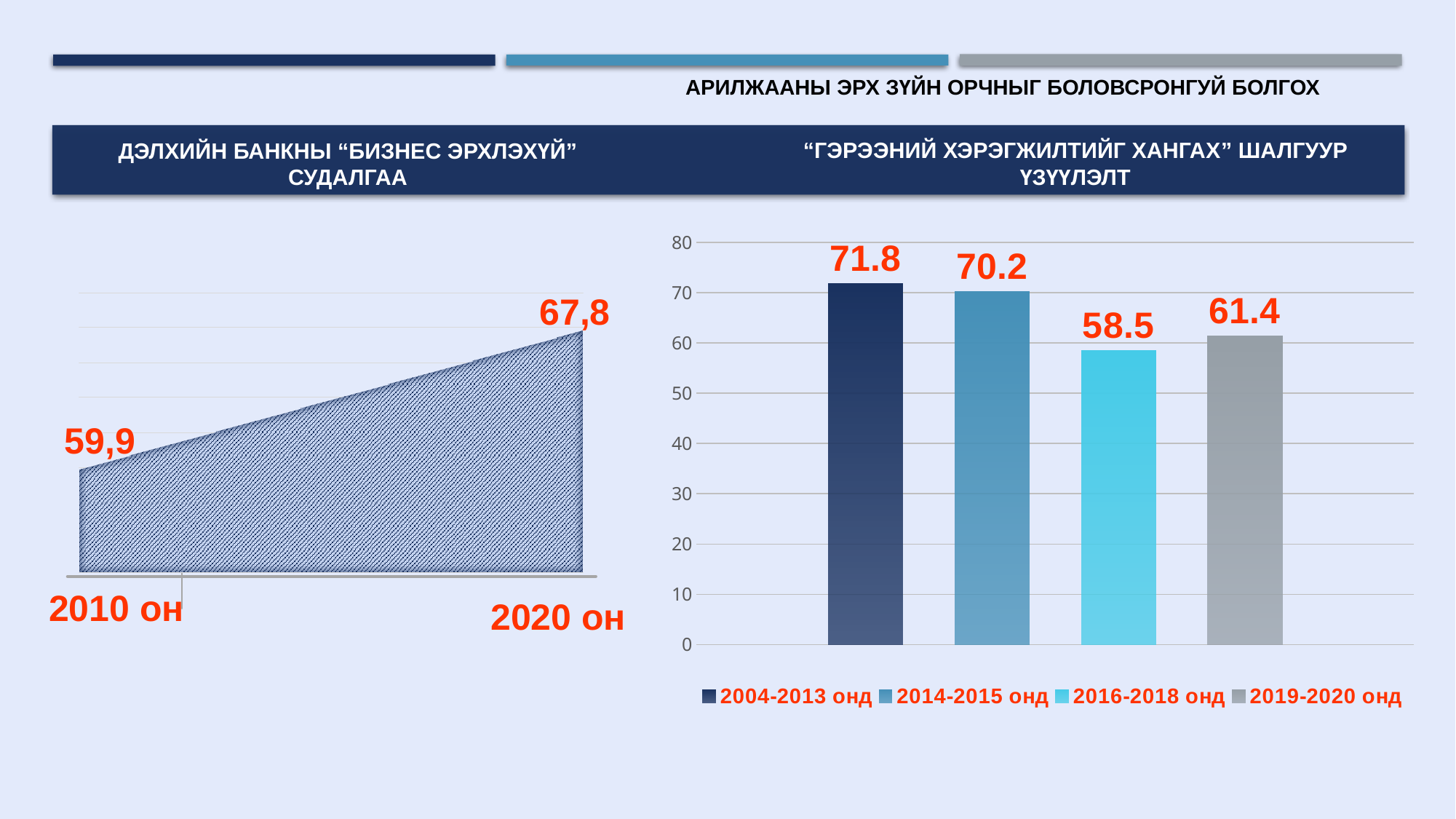
In the left chart (ДЭЛХИЙН БАНКНЫ “БИЗНЕС ЭРХЛЭХҮЙ” СУДАЛГАА), what is the value for 2010 он? 59,9 In the right chart (“ГЭРЭЭНИЙ ХЭРЭГЖИЛТИЙГ ХАНГАХ” ШАЛГУУР ҮЗҮҮЛЭЛТ), what is the value for 2004-2013 онд? 71.8 In the right chart (“ГЭРЭЭНИЙ ХЭРЭГЖИЛТИЙГ ХАНГАХ” ШАЛГУУР ҮЗҮҮЛЭЛТ), what is the value for 2016-2018 онд? 58.5 In the right chart (“ГЭРЭЭНИЙ ХЭРЭГЖИЛТИЙГ ХАНГАХ” ШАЛГУУР ҮЗҮҮЛЭЛТ), how many entries does the legend list? 4 In the right chart (“ГЭРЭЭНИЙ ХЭРЭГЖИЛТИЙГ ХАНГАХ” ШАЛГУУР ҮЗҮҮЛЭЛТ), which period has the lowest value? 2016-2018 онд In the right chart (“ГЭРЭЭНИЙ ХЭРЭГЖИЛТИЙГ ХАНГАХ” ШАЛГУУР ҮЗҮҮЛЭЛТ), what is the difference between the 2014-2015 онд and 2019-2020 онд values? 8.8 In the left chart (ДЭЛХИЙН БАНКНЫ “БИЗНЕС ЭРХЛЭХҮЙ” СУДАЛГАА), what is the value for 2020 он? 67,8 In the left chart (ДЭЛХИЙН БАНКНЫ “БИЗНЕС ЭРХЛЭХҮЙ” СУДАЛГАА), does the value rise or fall from 2010 он to 2020 он? rise What kind of chart is the left chart (ДЭЛХИЙН БАНКНЫ “БИЗНЕС ЭРХЛЭХҮЙ” СУДАЛГАА)? area chart In the left chart (ДЭЛХИЙН БАНКНЫ “БИЗНЕС ЭРХЛЭХҮЙ” СУДАЛГАА), what is the difference between the 2020 он and 2010 он values? 7,9 What kind of chart is the right chart (“ГЭРЭЭНИЙ ХЭРЭГЖИЛТИЙГ ХАНГАХ” ШАЛГУУР ҮЗҮҮЛЭЛТ)? bar chart In the right chart (“ГЭРЭЭНИЙ ХЭРЭГЖИЛТИЙГ ХАНГАХ” ШАЛГУУР ҮЗҮҮЛЭЛТ), which period has the highest value? 2004-2013 онд